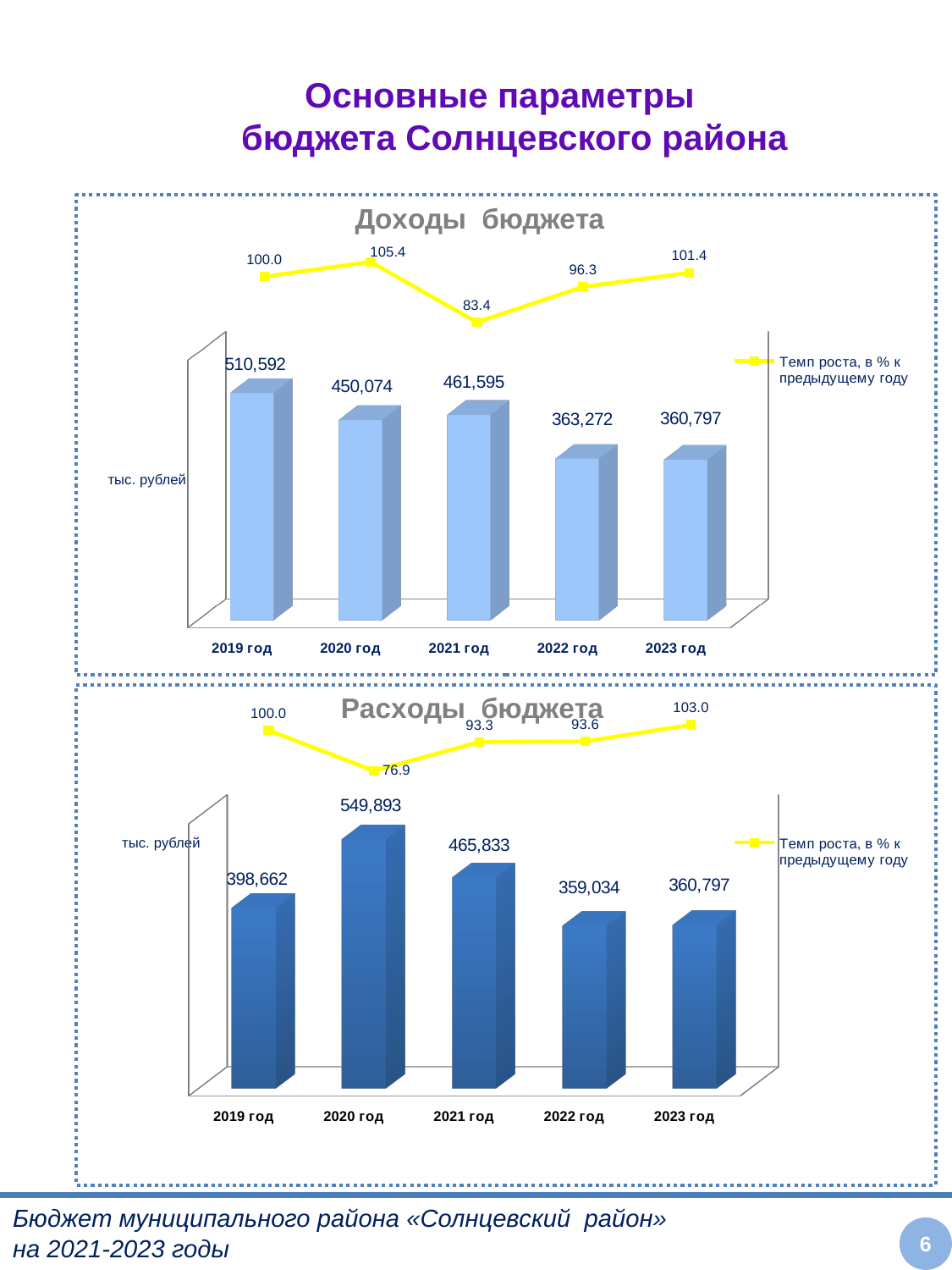
In the "Расходы бюджета" chart, what is the value for 2020 год? 549,893 What unit is indicated on the vertical axis of the "Расходы бюджета" chart? тыс. рублей In the "Расходы бюджета" chart, which is larger: the value for 2021 год or the value for 2022 год? 2021 год In the "Расходы бюджета" chart, what is the difference between the values for 2020 год and 2019 год? 151,231 In the "Расходы бюджета" chart, what is the growth rate (Темп роста) value for 2020 год? 76.9 In the "Расходы бюджета" chart, which year has the lowest bar value? 2022 год How many years (categories) are shown in the "Доходы бюджета" chart? 5 In the "Доходы бюджета" chart, what is the value for 2019 год? 510,592 In the "Доходы бюджета" chart, what is the growth rate (Темп роста) value for 2021 год? 83.4 In the "Доходы бюджета" chart, which year has the highest bar value? 2019 год In the "Доходы бюджета" chart, what is the difference between the values for 2019 год and 2023 год? 149,795 In the "Доходы бюджета" chart, which year has the lowest bar value? 2023 год